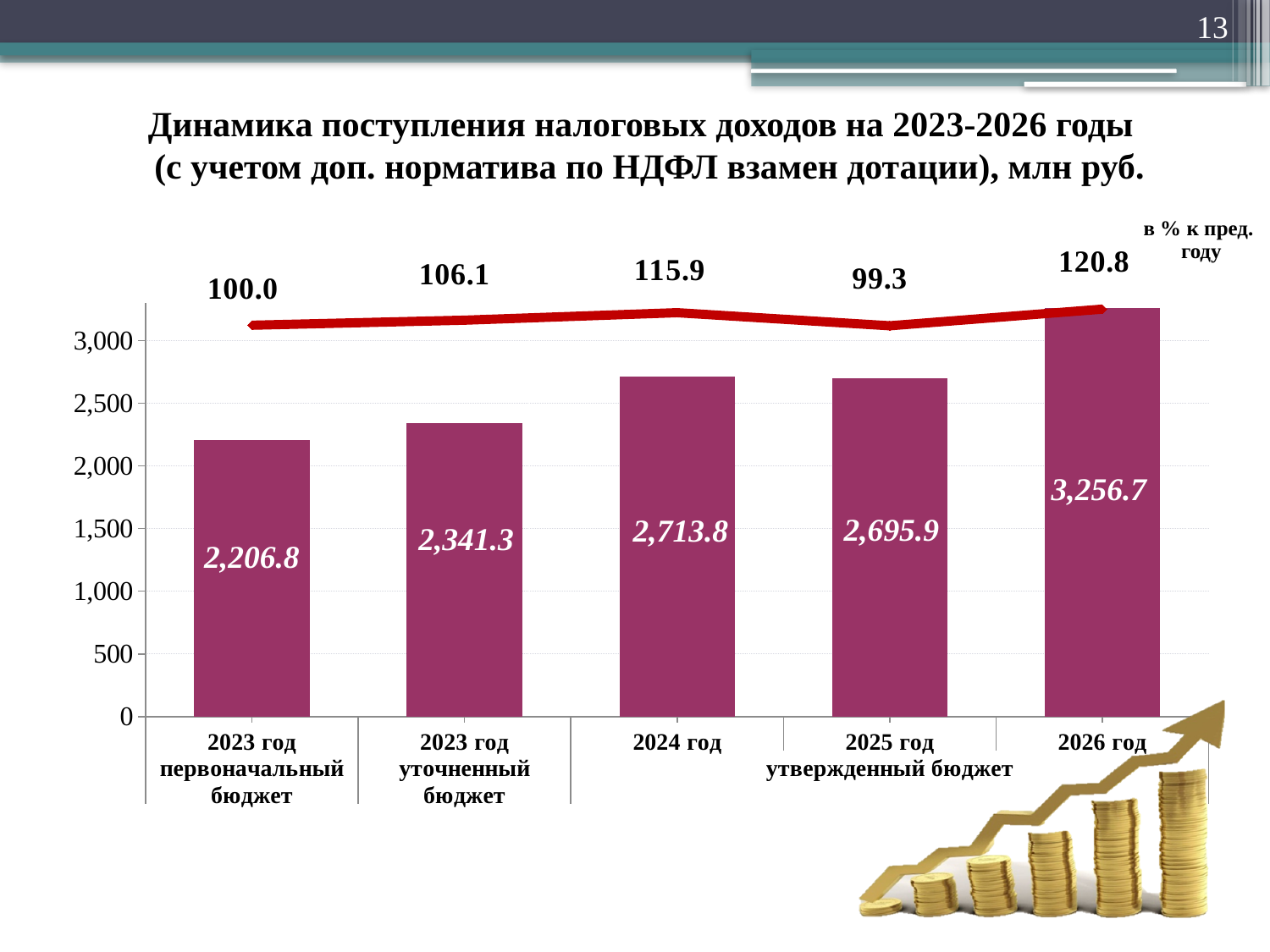
How many bars are shown in the chart? 5 Which category has the lowest value? 2023 год первоначальный бюджет What percentage to the previous year is shown above the 2026 год bar? 120.8 What percentage to the previous year is shown above the 2025 год bar? 99.3 What kind of chart is this? combination bar and line chart What is the value for 2024 год? 2,713.8 What is the value for 2023 год первоначальный бюджет? 2,206.8 Which category has the highest value? 2026 год Which is larger, the value for 2024 год or the value for 2025 год? 2024 год What is the difference between the values for 2023 год уточненный бюджет and 2023 год первоначальный бюджет? 134.5 Is the value for 2026 год greater or less than 3,000? greater What is the difference between the values for 2026 год and 2025 год? 560.8